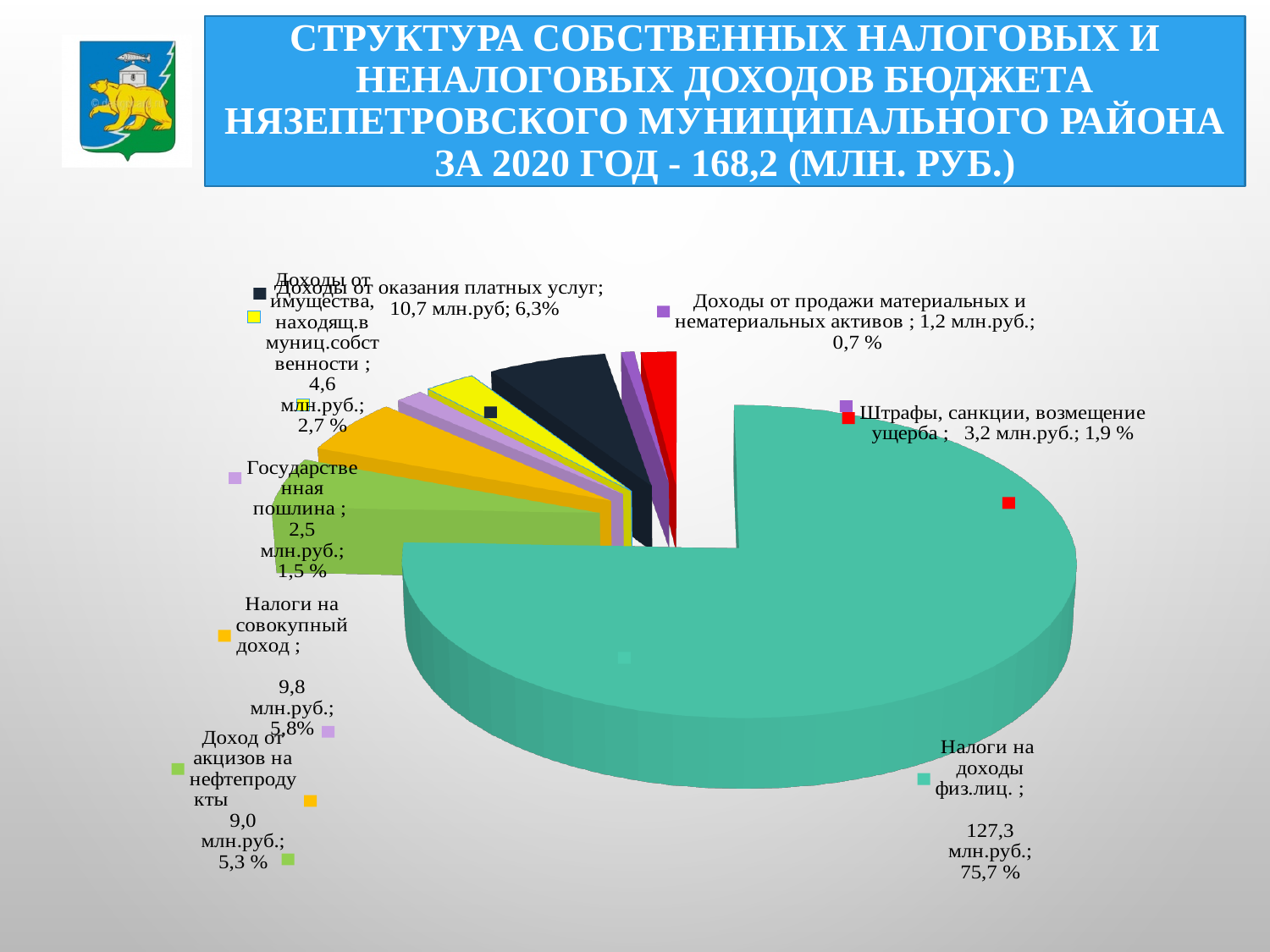
Which category has the largest share of the pie? Налоги на доходы физ.лиц. Which category has the smallest share of the pie? Доходы от продажи материальных и нематериальных активов How many categories (slices) does the pie chart show? 8 What total amount in млн. руб. is stated in the chart title for 2020? 168,2 What is the value for "Доходы от оказания платных услуг"? 10,7 млн.руб What is the value for "Штрафы, санкции, возмещение ущерба"? 3,2 млн.руб. What is the value for "Налоги на доходы физ.лиц."? 127,3 млн.руб. What is the difference in млн.руб. between "Доходы от оказания платных услуг" and "Налоги на совокупный доход"? 0,9 млн.руб. Which is larger: "Доход от акцизов на нефтепродукты" or "Государственная пошлина"? Доход от акцизов на нефтепродукты What kind of chart is shown on the slide? pie chart What percentage is shown for "Налоги на совокупный доход"? 5,8% What share of the pie does "Налоги на доходы физ.лиц." represent? 75,7 %